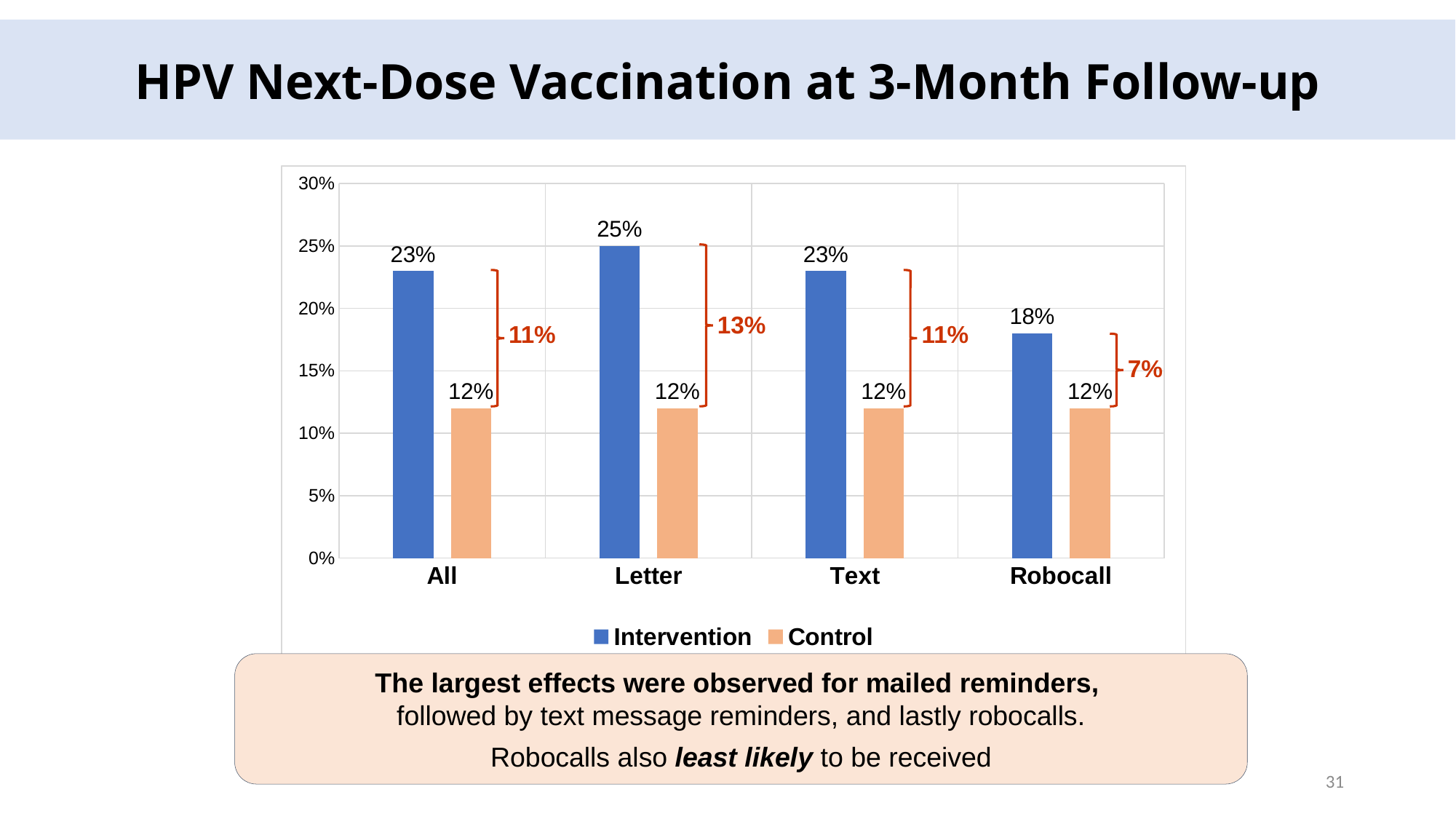
What is the difference between the Intervention and Control values for Robocall? 7% How many categories are shown on the x axis? 4 What kind of chart is shown on the slide? Bar chart Which is larger, the Intervention value for Text or the Intervention value for Robocall? Intervention value for Text Which category has the lowest Intervention value? Robocall What is the Intervention value for Letter? 25% What is the difference between the Intervention and Control values for Letter? 13% What is the Control value for Text? 12% What colour are the Control bars? Orange How many series does the legend list? 2 What is the Intervention value for Robocall? 18% Which category has the highest Intervention value? Letter